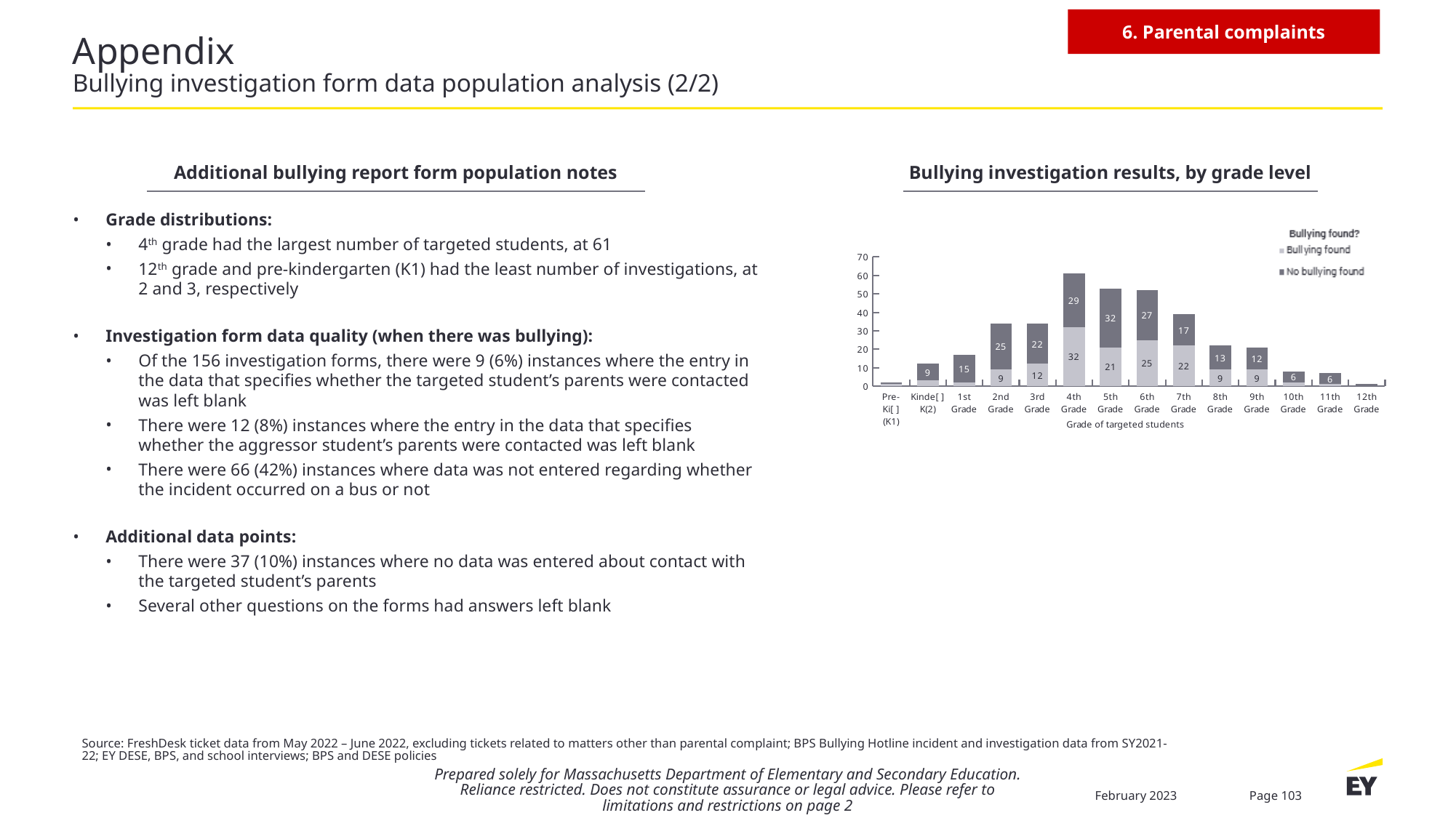
In the 'Bullying investigation results, by grade level' chart, what is the 'No bullying found' value for 1st Grade? 15 In the 'Bullying investigation results, by grade level' chart, what is the difference between 'No bullying found' and 'Bullying found' for 6th Grade? 2 What kind of chart is used in 'Bullying investigation results, by grade level'? Stacked bar chart In the 'Bullying investigation results, by grade level' chart, what is the total of the 8th Grade stacked bar? 22 In the 'Bullying investigation results, by grade level' chart, what is the 'Bullying found' value for 4th Grade? 32 Which grade has the tallest stacked bar in the 'Bullying investigation results, by grade level' chart? 4th Grade In the 'Bullying investigation results, by grade level' chart, what is the 'No bullying found' value for 5th Grade? 32 In the 'Bullying investigation results, by grade level' chart, for 7th Grade, which is larger: 'Bullying found' or 'No bullying found'? Bullying found In the 'Bullying investigation results, by grade level' chart, what is the total of the 4th Grade stacked bar? 61 In the 'Bullying investigation results, by grade level' chart, is the total for 5th Grade greater or less than 50? greater How many series does the legend of the 'Bullying investigation results, by grade level' chart list? 2 How many grade categories are shown on the x axis of the 'Bullying investigation results, by grade level' chart? 14